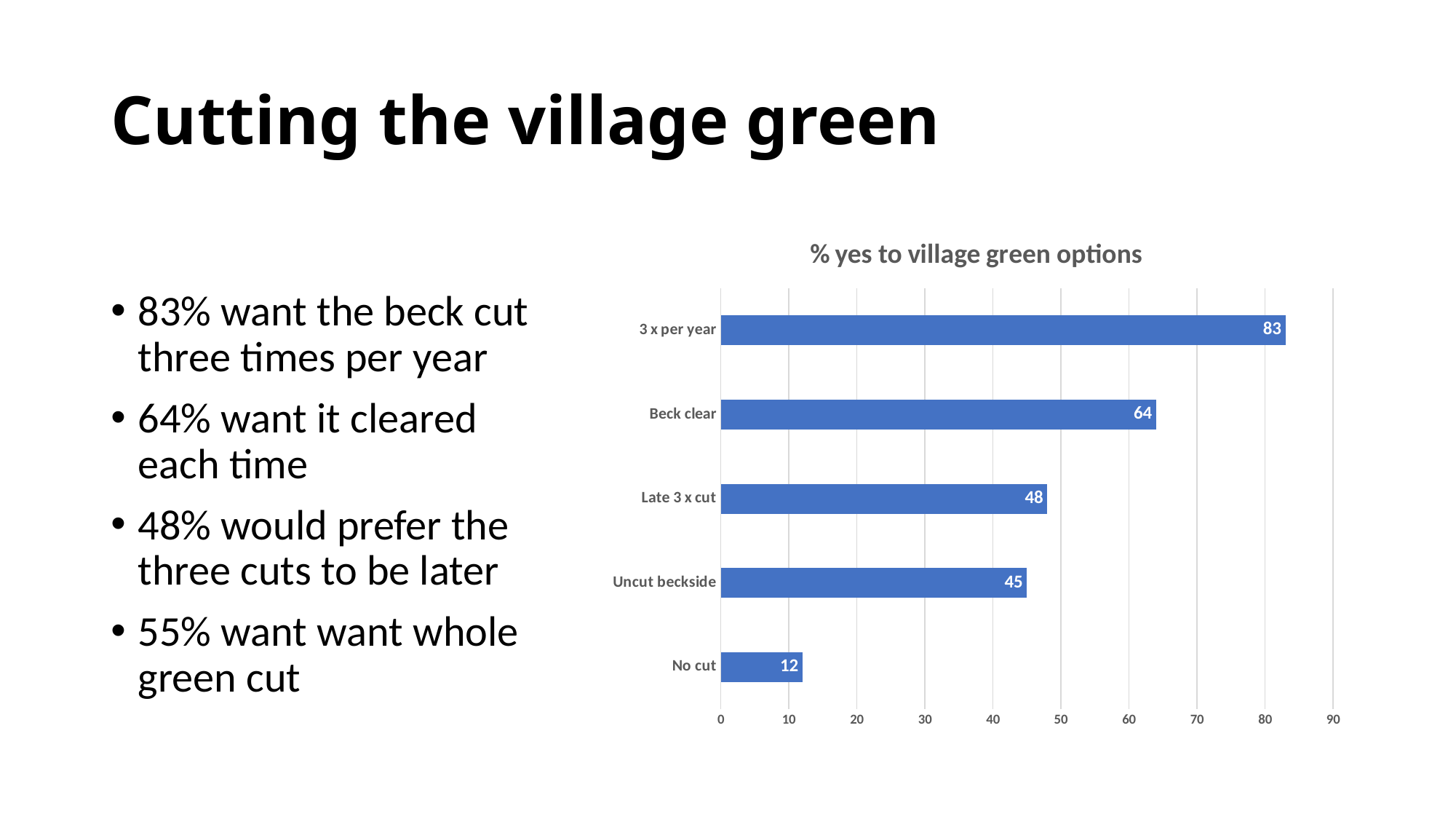
What is the value for "Beck clear"? 64 How many categories are shown in the chart? 5 What is the difference between the values for "3 x per year" and "Beck clear"? 19 What kind of chart is shown on the slide? Bar chart What is the title of the chart? % yes to village green options What is the value for "No cut"? 12 What is the value for "Uncut beckside"? 45 What is the value for "Late 3 x cut"? 48 Which category has the lowest value? No cut Which is larger, the value for "Late 3 x cut" or "Uncut beckside"? Late 3 x cut Which category has the highest value? 3 x per year What is the value for "3 x per year"? 83